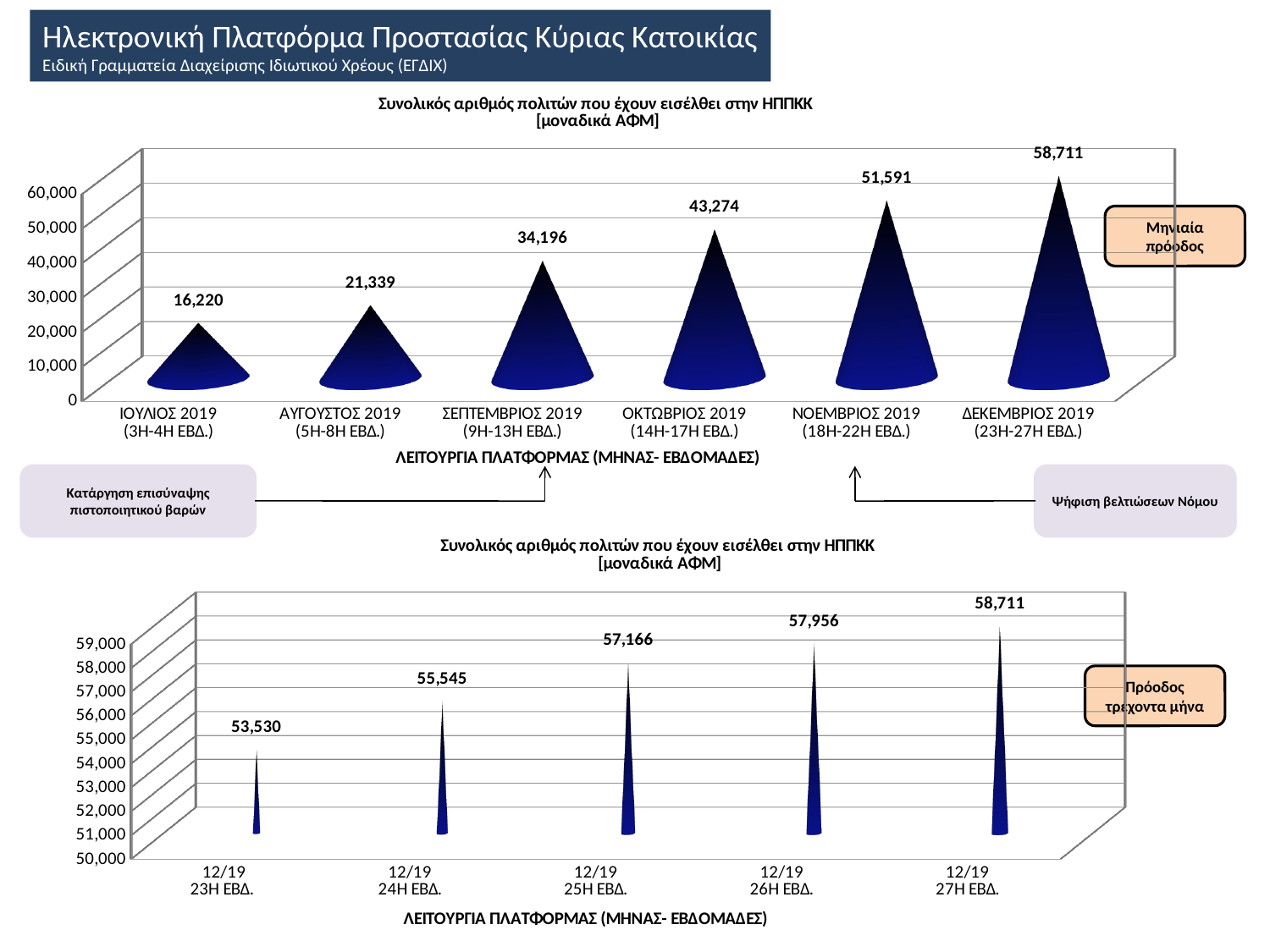
In the bottom chart, what is the value for 12/19 23Η ΕΒΔ.? 53,530 In the top chart, what is the value for ΙΟΥΛΙΟΣ 2019? 16,220 In the bottom chart, how many weeks are plotted? 5 In the bottom chart, what is the difference between the values for 27Η ΕΒΔ. and 26Η ΕΒΔ.? 755 In the bottom chart, what is the value for 12/19 25Η ΕΒΔ.? 57,166 In the top chart, what is the value for ΣΕΠΤΕΜΒΡΙΟΣ 2019? 34,196 In the top chart, what is the difference between the values for ΝΟΕΜΒΡΙΟΣ 2019 and ΟΚΤΩΒΡΙΟΣ 2019? 8,317 In the top chart, how many months are plotted? 6 In the top chart, which month has the highest value? ΔΕΚΕΜΒΡΙΟΣ 2019 In the top chart, which month has the lowest value? ΙΟΥΛΙΟΣ 2019 What kind of chart is the bottom chart? bar chart In the top chart, do the values rise or fall from ΙΟΥΛΙΟΣ 2019 to ΔΕΚΕΜΒΡΙΟΣ 2019? rise